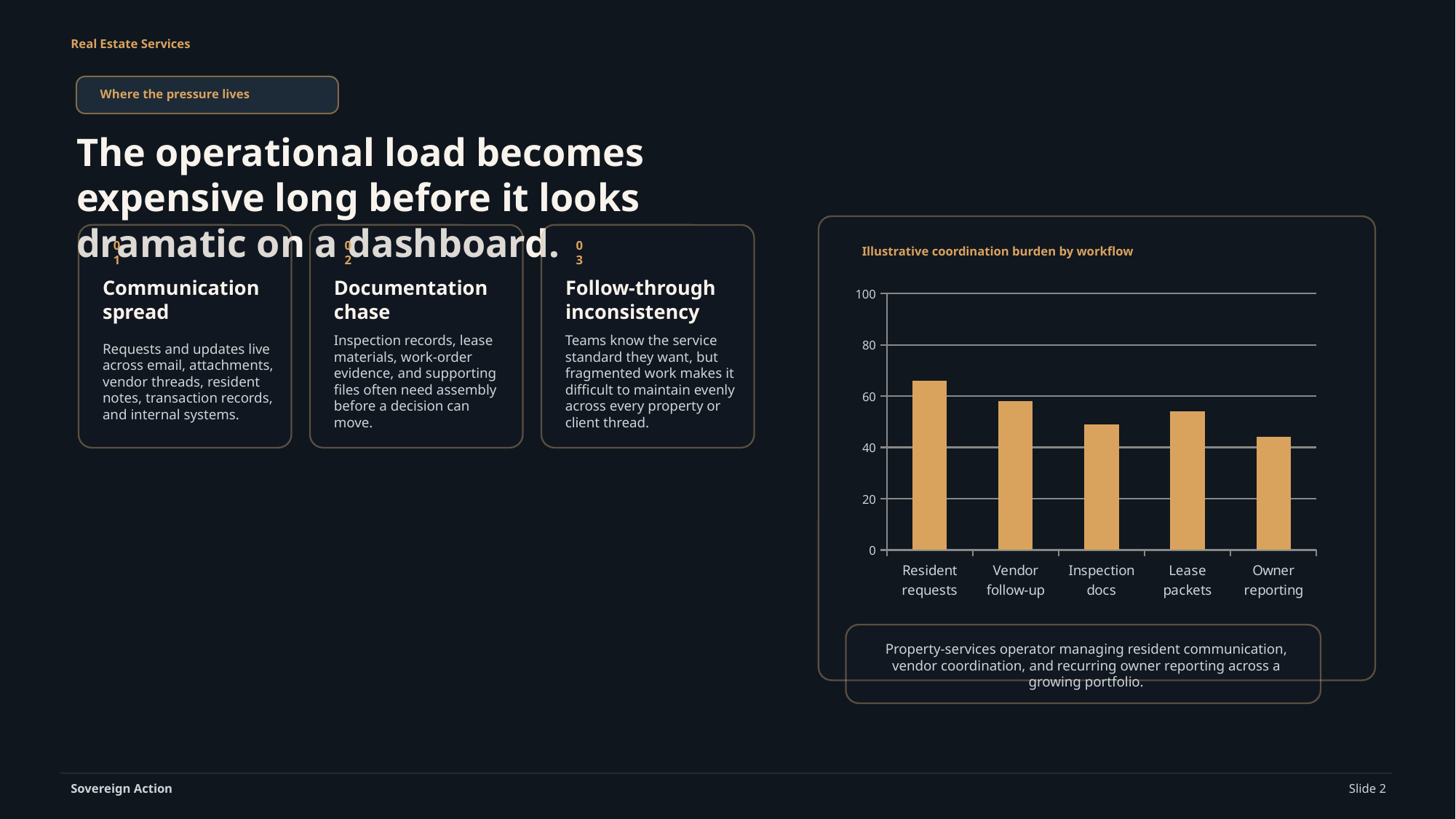
What kind of chart is shown on the slide? Bar chart Is the value for Inspection docs greater or less than 40? greater Is the value for Resident requests greater or less than 60? greater Which workflow has the lowest coordination burden in the chart? Owner reporting What is the highest value shown on the chart's vertical axis? 100 How many workflow categories are plotted in the chart? 5 Which workflow has the highest coordination burden in the chart? Resident requests Is the value for Owner reporting greater or less than 60? less Which is larger, the value for Vendor follow-up or the value for Inspection docs? Vendor follow-up What is the title of the chart? Illustrative coordination burden by workflow Which is larger, the value for Resident requests or the value for Owner reporting? Resident requests